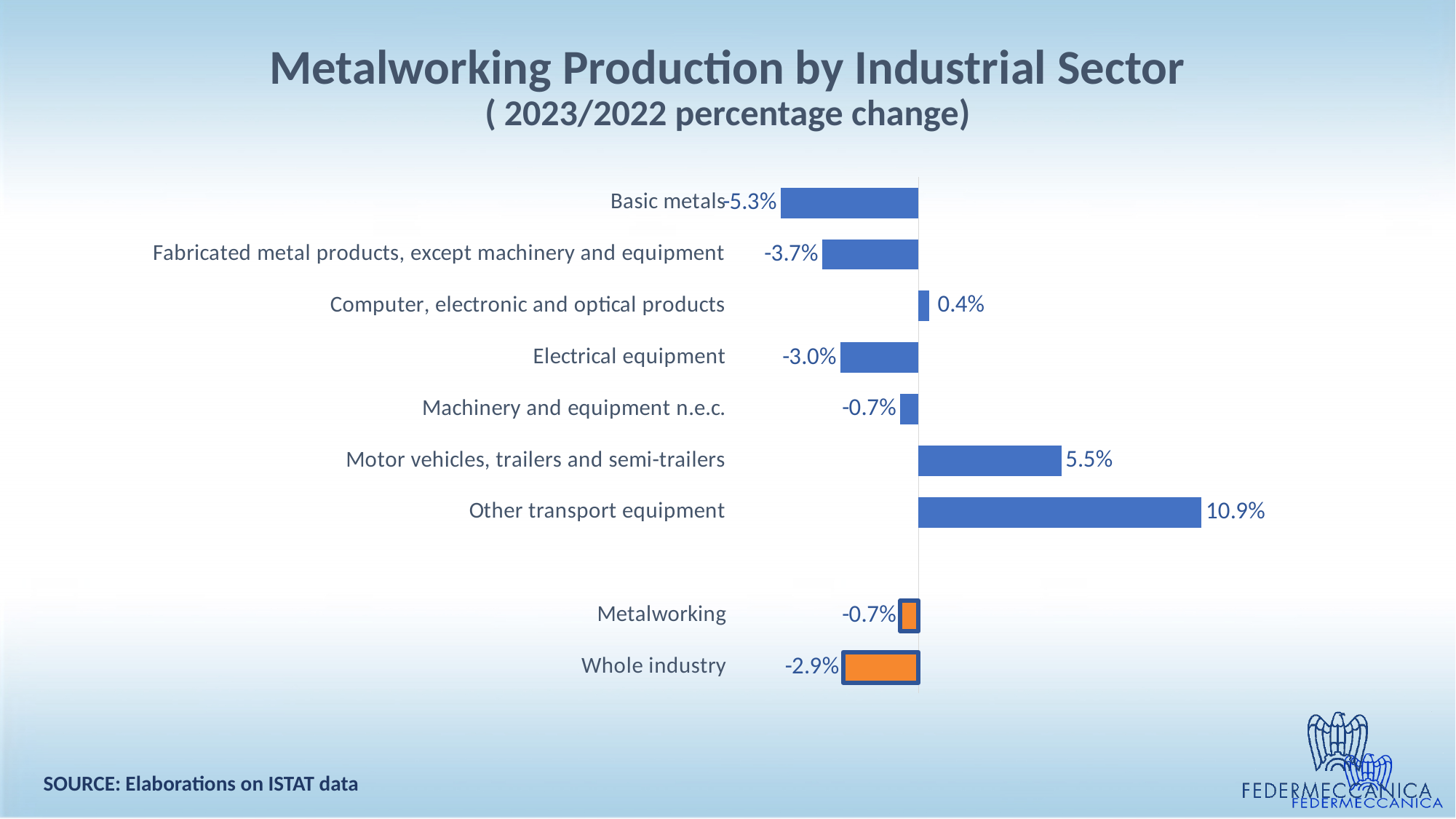
What kind of chart is shown on the slide? Bar chart How many categories are plotted in the chart? 9 What is the percentage change shown for Other transport equipment? 10.9% What is the difference between the percentage change for Metalworking and Whole industry? 2.2 percentage points Which has a larger percentage change, Electrical equipment or Fabricated metal products, except machinery and equipment? Electrical equipment Which two categories are shown with orange bars? Metalworking and Whole industry Which category has the lowest percentage change? Basic metals What is the percentage change shown for Motor vehicles, trailers and semi-trailers? 5.5% What is the 2023/2022 percentage change for Basic metals? -5.3% What is the difference between the percentage change for Other transport equipment and Motor vehicles, trailers and semi-trailers? 5.4 percentage points Which category has the highest percentage change? Other transport equipment What is the percentage change shown for Whole industry? -2.9%